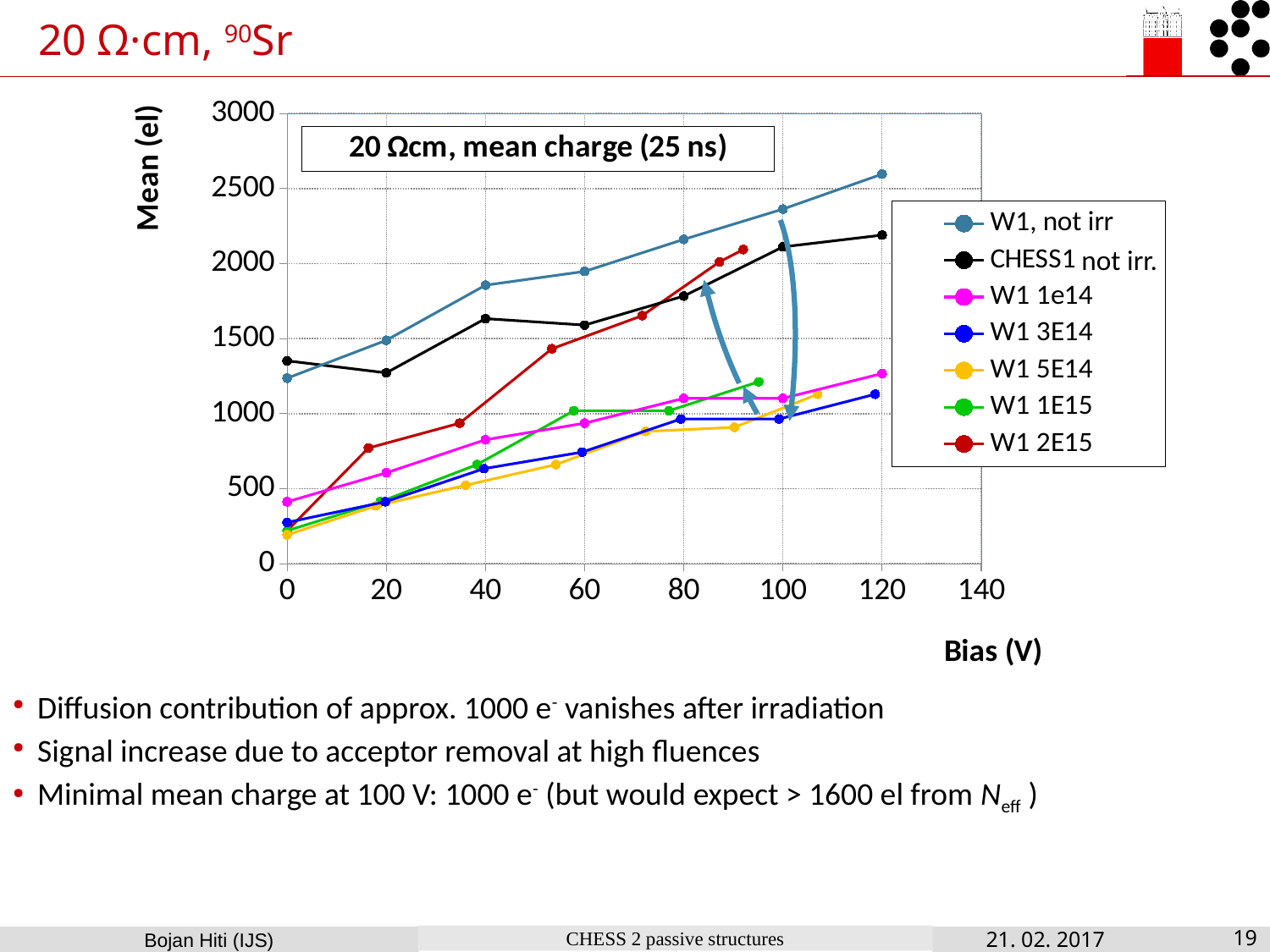
Is the value for W1 1e14 at 120 V greater or less than 1000? greater How many series does the legend list? 7 At 120 V, which series has the higher value: W1, not irr or CHESS1 not irr.? W1, not irr Is the value for W1, not irr at 120 V greater or less than 2500? greater Which series has the highest value at 120 V? W1, not irr Is the value for W1 2E15 at 0 V greater or less than 500? less Does the W1, not irr series rise or fall as bias increases? rise What is the label of the x axis? Bias (V) What kind of chart is shown on the slide? line chart What is the title of the chart? 20 Ωcm, mean charge (25 ns)